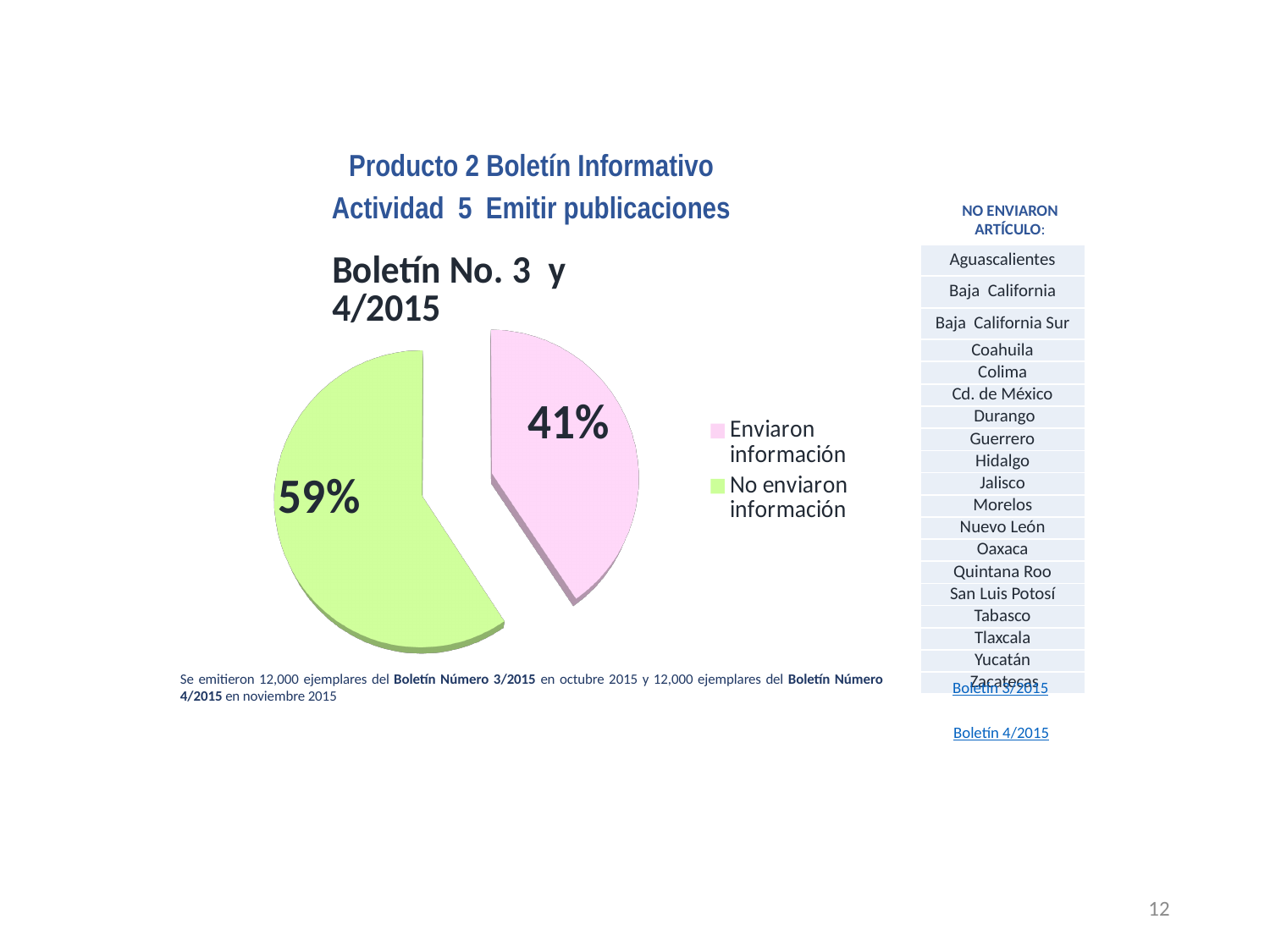
Which is larger, the "Enviaron información" slice or the "No enviaron información" slice? No enviaron información What percentage of the pie is labelled "Enviaron información"? 41% What kind of chart is shown on the slide? pie chart What colour is the "No enviaron información" slice? green How many entries does the legend list? 2 What percentage of the pie is labelled "No enviaron información"? 59% Which slice of the pie is the largest? No enviaron información What is the chart's title? Boletín No. 3 y 4/2015 What is the difference in percentage points between the "No enviaron información" and "Enviaron información" slices? 18 Is the share for "Enviaron información" greater or less than 50%? less How many slices does the pie chart have? 2 Which slice of the pie is the smallest? Enviaron información